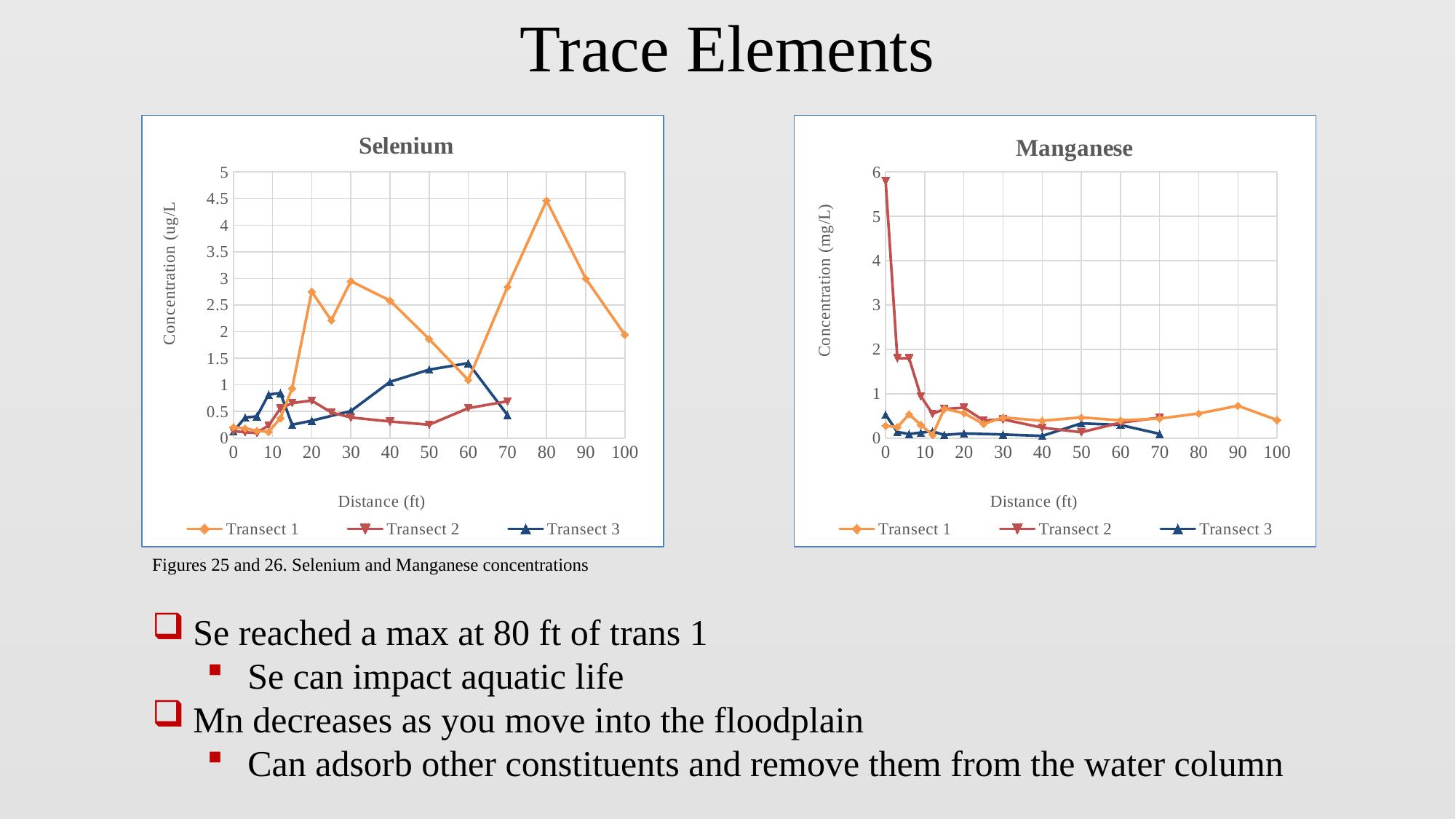
In the Manganese chart, is the value for Transect 2 at 0 ft greater or less than 5? greater What is the x-axis label of the Selenium chart? Distance (ft) How many series does the legend of the Manganese chart list? 3 In the Manganese chart, which series has the highest value at 0 ft? Transect 2 In the Selenium chart, at which distance does Transect 1 reach its highest value? 80 What is the y-axis label of the Manganese chart? Concentration (mg/L) In the Selenium chart, is the value for Transect 2 at 50 ft greater or less than 0.5? less In the Selenium chart, is the value for Transect 1 at 80 ft greater or less than 4? greater In the Manganese chart, does Transect 2 rise or fall between 0 ft and 10 ft? fall What kind of chart is the Selenium chart? line chart In the Selenium chart, which series has the larger value at 30 ft, Transect 1 or Transect 2? Transect 1